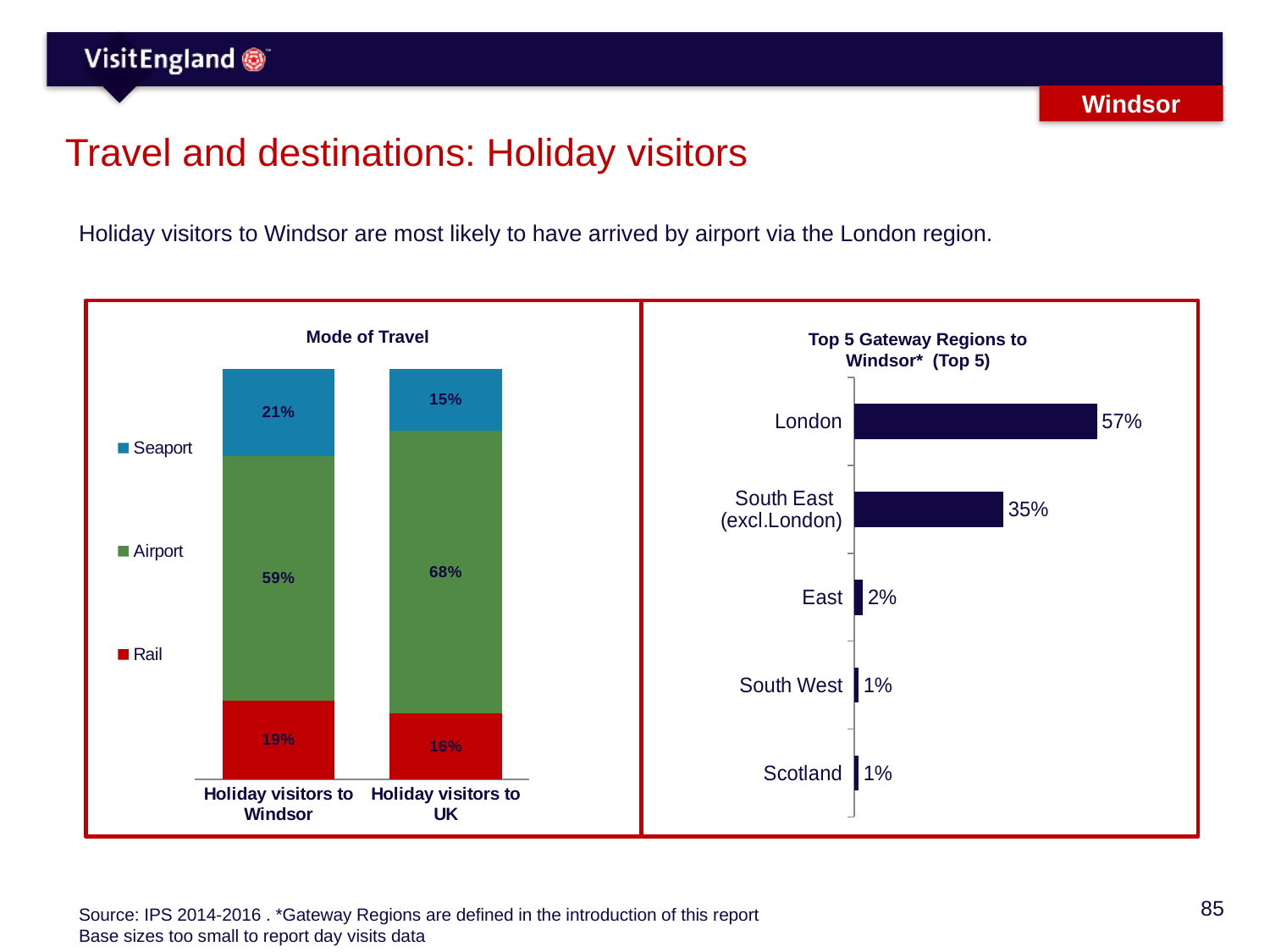
What kind of chart is the Top 5 Gateway Regions to Windsor chart? Bar chart In the Mode of Travel chart, what is the difference between the Airport share for holiday visitors to UK and for holiday visitors to Windsor? 9% In the Mode of Travel chart, what is the Rail value for holiday visitors to Windsor? 19% In the Mode of Travel chart, how many series does the legend list? 3 In the Top 5 Gateway Regions to Windsor chart, what is the difference between London and South East (excl.London)? 22% In the Mode of Travel chart, what is the Seaport value for holiday visitors to UK? 15% In the Mode of Travel chart, what is the total of the stacked bar for holiday visitors to Windsor? 99% In the Top 5 Gateway Regions to Windsor chart, which region has the highest value? London In the Top 5 Gateway Regions to Windsor chart, what is the value for South East (excl.London)? 35% In the Mode of Travel chart, what percentage of holiday visitors to Windsor arrived by airport? 59% In the Mode of Travel chart, which is larger: the Seaport share for holiday visitors to Windsor or for holiday visitors to UK? Holiday visitors to Windsor In the Top 5 Gateway Regions to Windsor chart, how many regions are shown? 5